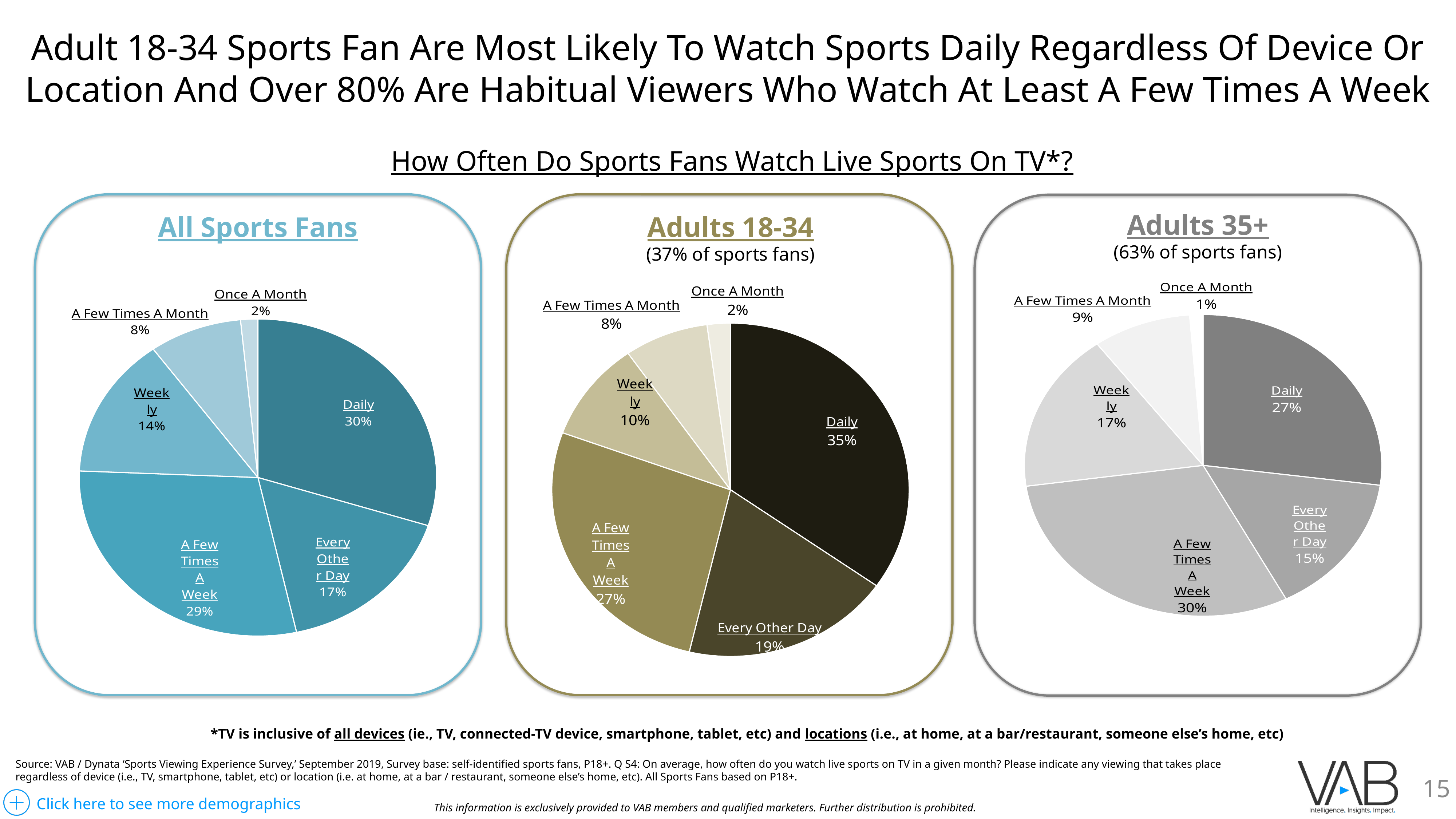
In the Adults 35+ chart, which is larger: Weekly or Every Other Day? Weekly In the Adults 35+ chart, what percentage watch a few times a week? 30% What type of chart is used in the Adults 35+ panel? Pie chart What is the difference between the Daily share in the Adults 18-34 chart and the Daily share in the Adults 35+ chart? 8 percentage points In the All Sports Fans chart, what share of fans watch live sports on TV daily? 30% In the Adults 18-34 chart, what percentage watch every other day? 19% In the All Sports Fans chart, which is larger: Daily or A Few Times A Week? Daily How many categories does each pie chart on the slide show? 6 According to the Adults 18-34 panel subtitle, what percentage of sports fans are adults 18-34? 37% In the Adults 18-34 chart, which category has the largest slice? Daily In the Adults 35+ chart, which category has the smallest slice? Once A Month In the All Sports Fans chart, which category has the smallest share? Once A Month